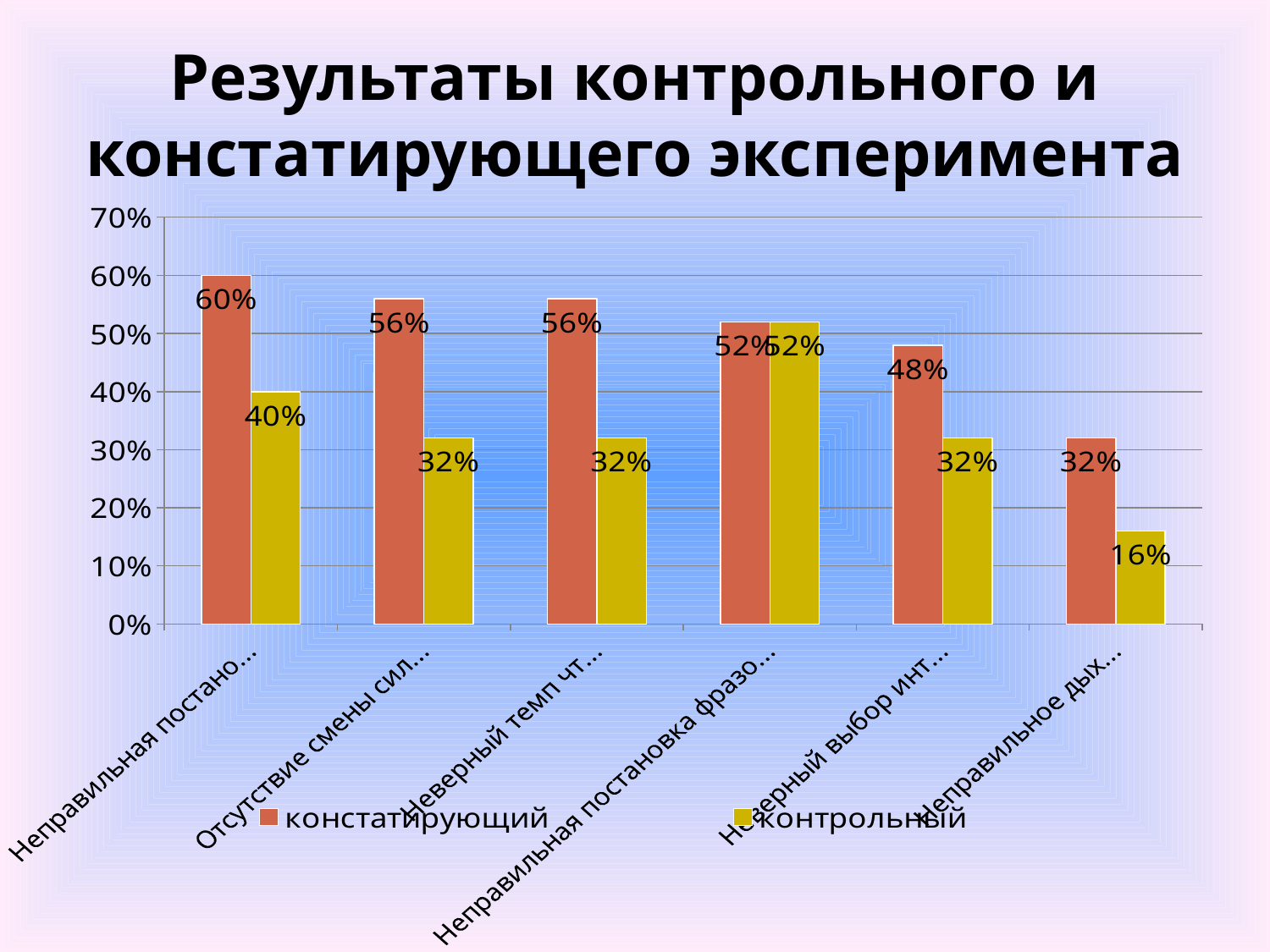
What is the value of the контрольный series for the first category (Неправильная постано...)? 40% For the fourth category (Неправильная постановка фразо...), which series has the larger value, констатирующий or контрольный? They are equal (52%) What is the value of the контрольный series for the last category (Неправильное дых...)? 16% Which category has the lowest value in the контрольный series? Неправильное дых... (the last category) How many series does the legend list? 2 What is the difference between the констатирующий and контрольный values for the first category (Неправильная постано...)? 20% How many categories are plotted along the x axis? 6 What kind of chart is shown on the slide? bar chart Which series is shown in yellow? контрольный What is the value of the констатирующий series for the fifth category (Неверный выбор инт...)? 48% What is the value of the констатирующий series for the first category (Неправильная постано...)? 60% Which category has the highest value in the констатирующий series? Неправильная постано... (the first category)